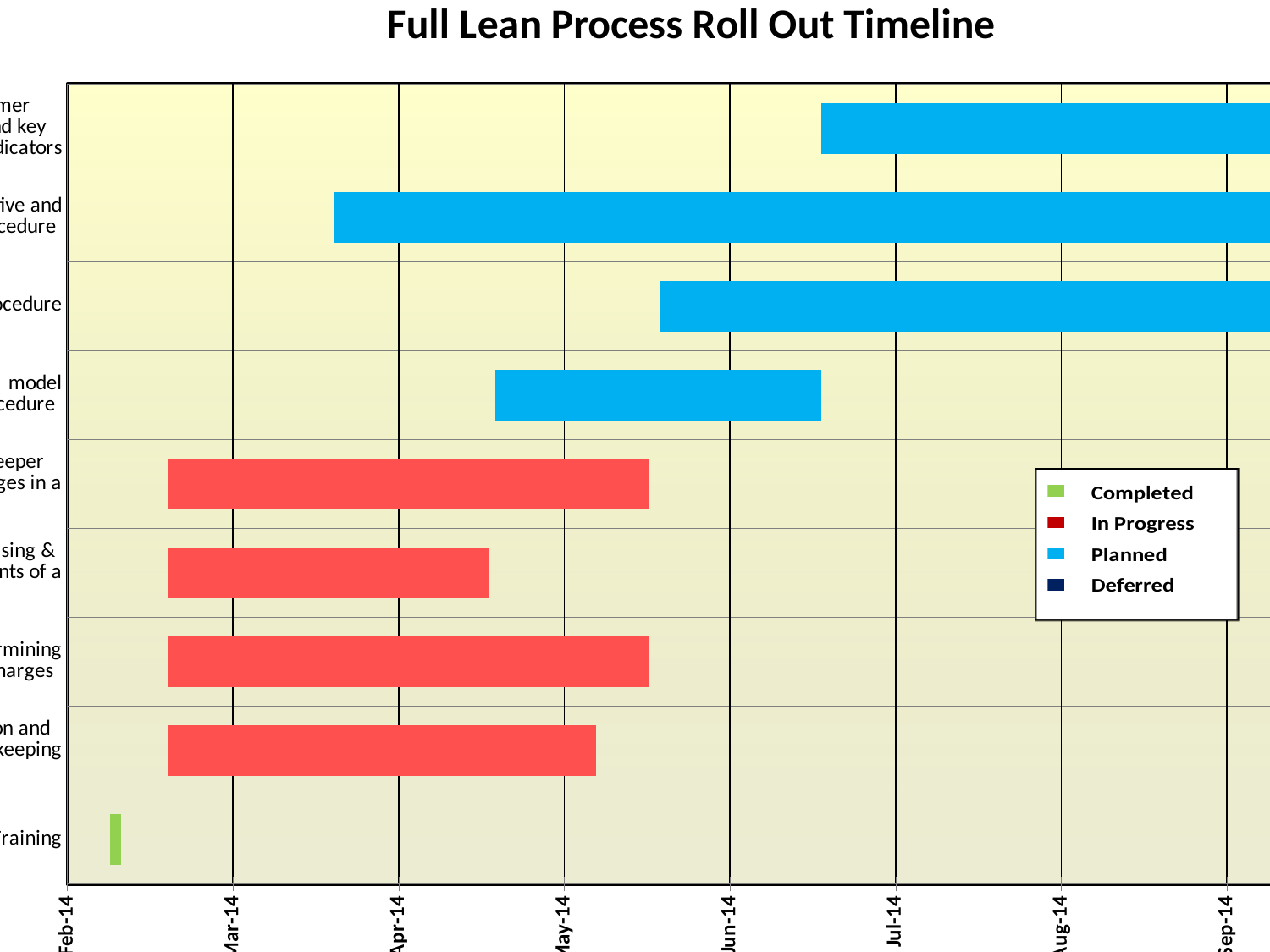
Does the Completed (green) bar fall before or after Mar-14 on the time axis? before How many bars on the chart are shown in the In Progress (red) colour? 4 Does the topmost Planned (blue) bar start before or after Jun-14? after How many bars on the chart are shown in the Completed (green) colour? 1 How many entries does the legend list? 4 How many bars on the chart are shown in the Planned (blue) colour? 4 What is the title of the chart? Full Lean Process Roll Out Timeline What kind of chart is shown on the slide? Bar chart (Gantt timeline) Which legend status has the fewest bars plotted on the chart (excluding statuses with none)? Completed What colour does the legend use for the Planned status? Blue